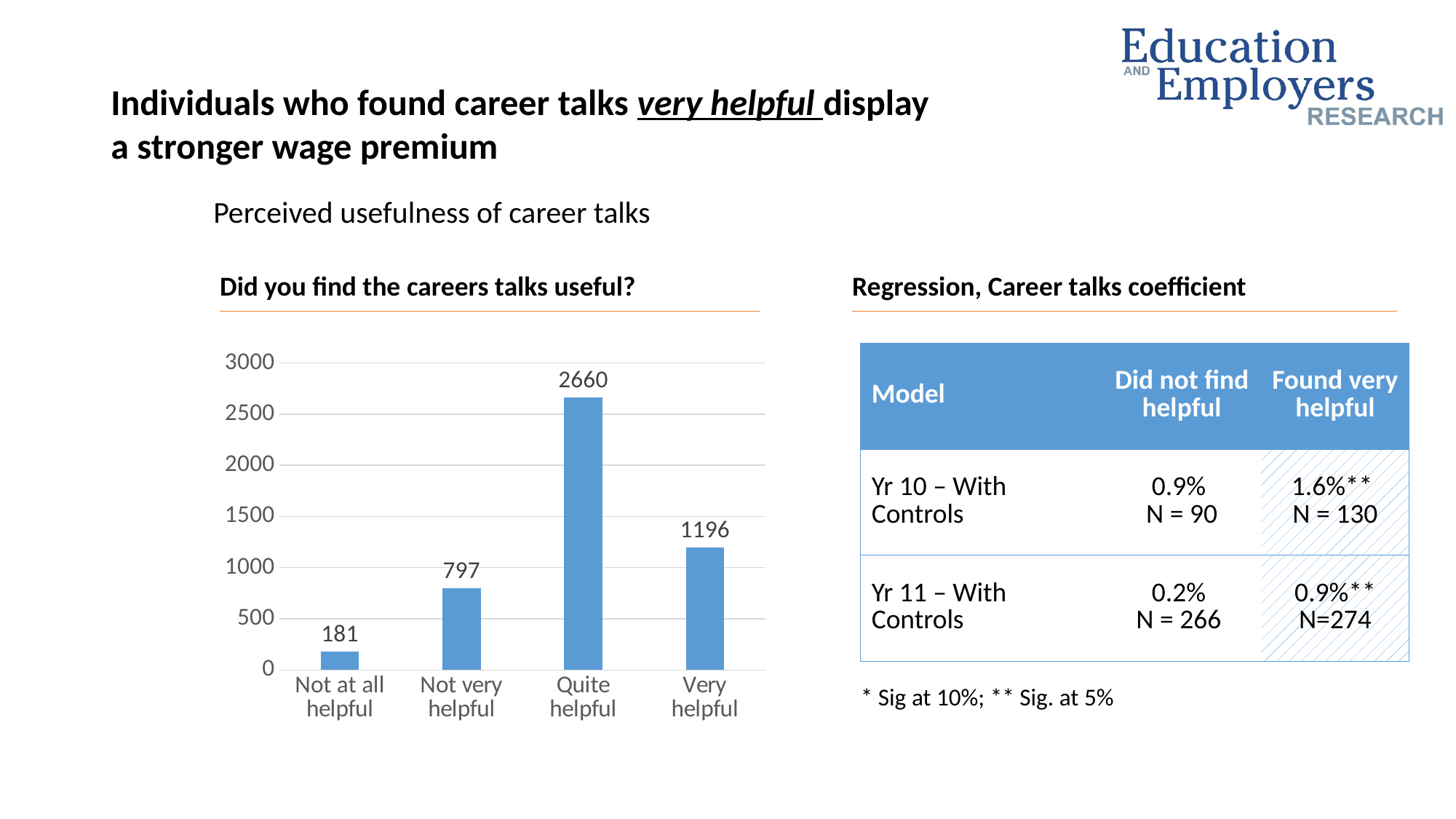
What is the difference between the values for "Not very helpful" and "Not at all helpful" in the chart "Did you find the careers talks useful?"? 616 What is the title of the chart on the left of the slide? Did you find the careers talks useful? In the chart "Did you find the careers talks useful?", which is larger: the value for "Not very helpful" or "Very helpful"? Very helpful What is the difference between the values for "Quite helpful" and "Very helpful" in the chart "Did you find the careers talks useful?"? 1464 What is the value for "Quite helpful" in the chart "Did you find the careers talks useful?"? 2660 What is the value for "Not very helpful" in the chart "Did you find the careers talks useful?"? 797 How many categories are shown in the chart "Did you find the careers talks useful?"? 4 What is the value for "Very helpful" in the chart "Did you find the careers talks useful?"? 1196 What is the value for "Not at all helpful" in the chart "Did you find the careers talks useful?"? 181 Which category has the highest value in the chart "Did you find the careers talks useful?"? Quite helpful What kind of chart is "Did you find the careers talks useful?"? Bar chart Which category has the lowest value in the chart "Did you find the careers talks useful?"? Not at all helpful